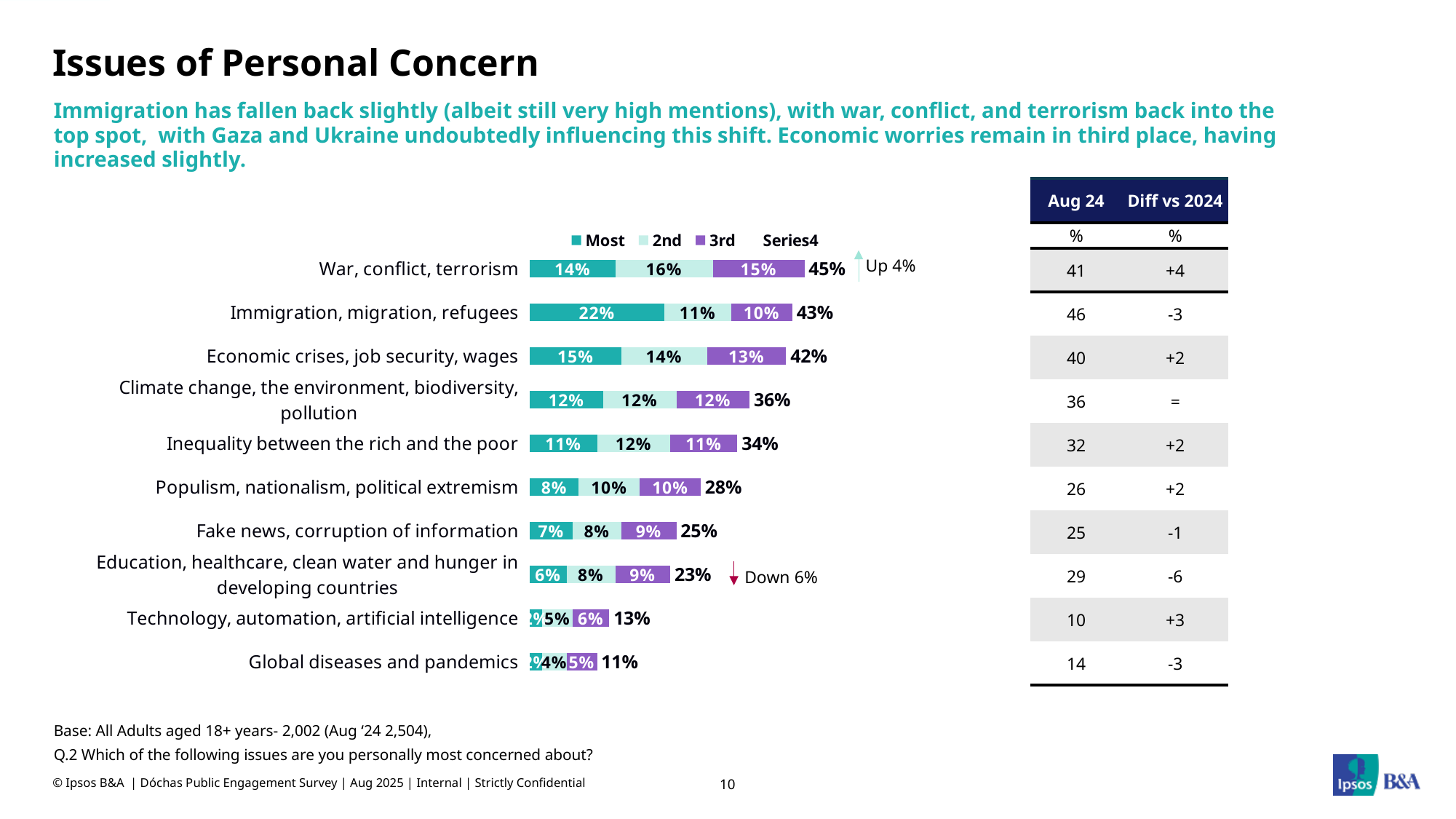
What annotation is shown next to the War, conflict, terrorism bar? Up 4% What is the difference between the total for War, conflict, terrorism and the total for Immigration, migration, refugees? 2% Which issue has the highest total in the chart? War, conflict, terrorism Which has the larger 'Most' value: Immigration, migration, refugees or Economic crises, job security, wages? Immigration, migration, refugees Which issue has the lowest total in the chart? Global diseases and pandemics What is the total for the War, conflict, terrorism bar? 45% What is the '2nd' value for War, conflict, terrorism? 16% How many series does the chart legend list? 4 What kind of chart is shown on the slide? bar chart How many issue categories are plotted in the chart? 10 What is the 'Most' value for Immigration, migration, refugees? 22% What is the '3rd' value for Economic crises, job security, wages? 13%